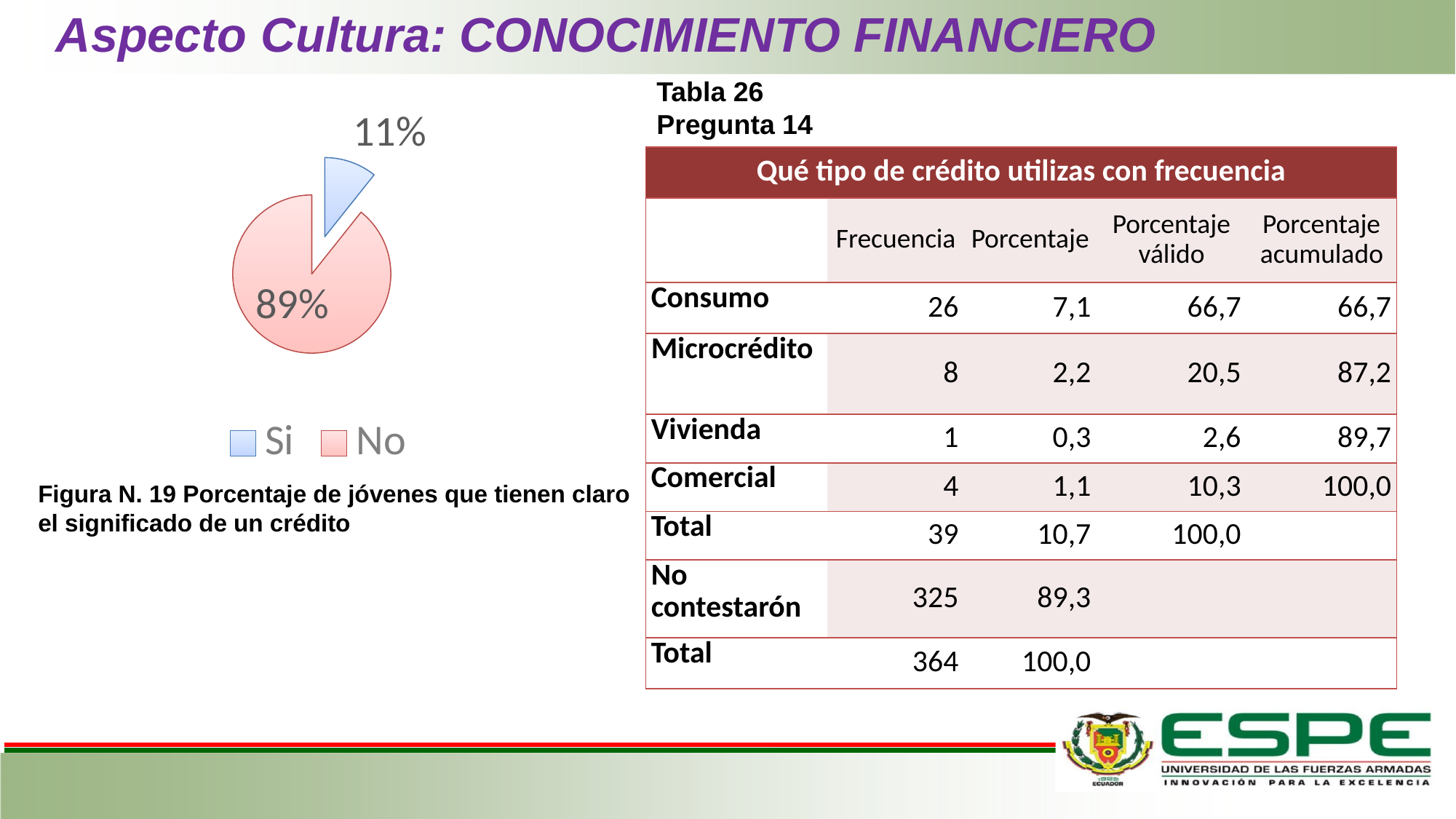
What colour is the "Si" slice in the pie chart? blue What percentage of the pie chart is labelled "No"? 89% What kind of chart is shown on the slide? pie chart How many entries does the pie chart's legend list? 2 What percentage of the pie chart is labelled "Si"? 11% What is the difference in percentage points between the "No" slice and the "Si" slice? 78 What share of the pie does the "No" slice represent? 89% Which slice of the pie chart is the largest? No How many slices does the pie chart have? 2 What is the figure caption of the pie chart? Figura N. 19 Porcentaje de jóvenes que tienen claro el significado de un crédito Which is larger in the pie chart, the "Si" slice or the "No" slice? No Which slice of the pie chart is the smallest? Si